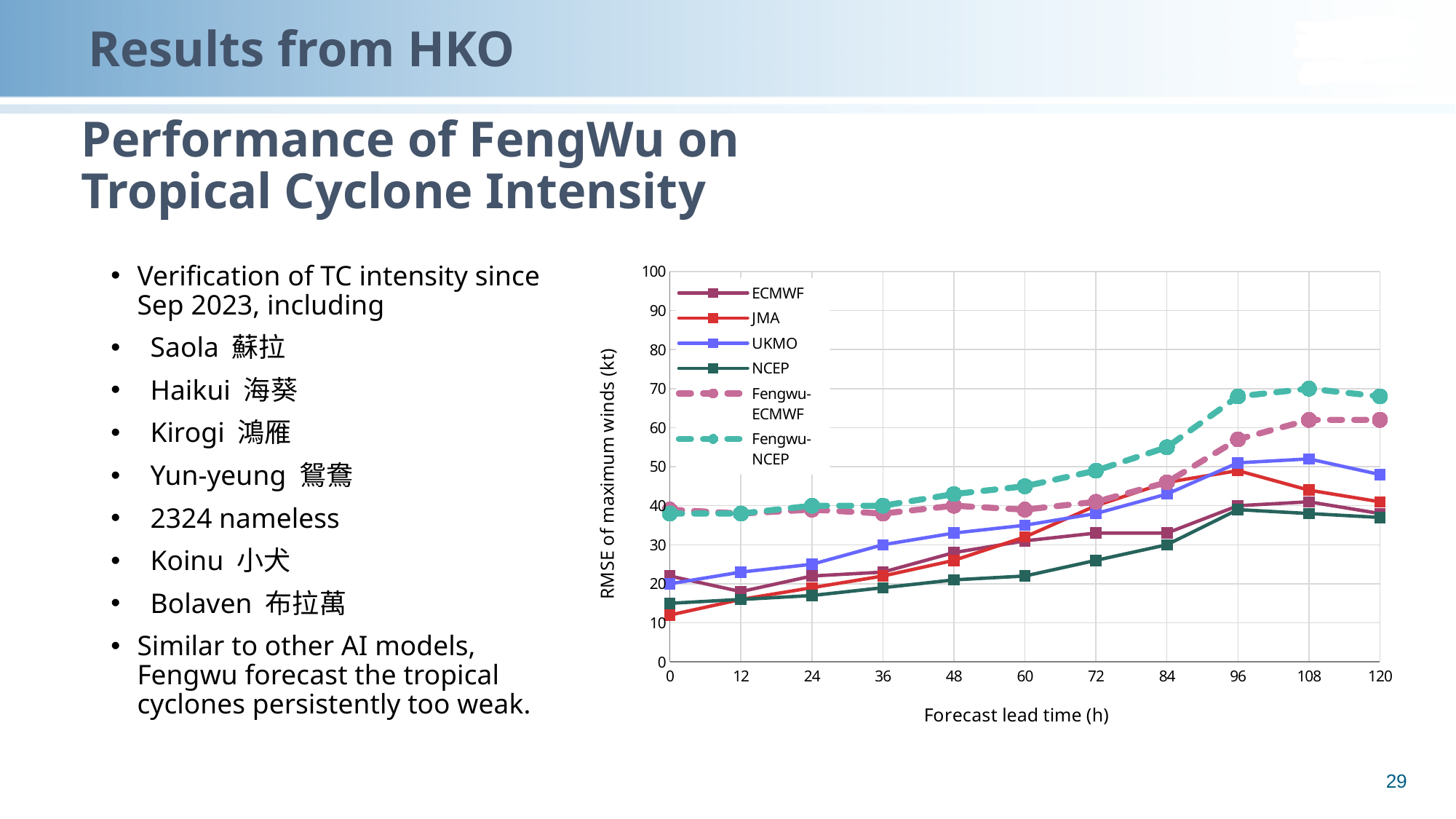
Which series has the highest RMSE at a forecast lead time of 108 h? Fengwu-NCEP Which series has the lowest RMSE at a forecast lead time of 72 h? NCEP What kind of chart is shown on the slide? line chart At a forecast lead time of 0 h, which has the larger RMSE: UKMO or JMA? UKMO Is the Fengwu-NCEP value at a forecast lead time of 120 h greater or less than 60? greater What is the label of the y axis of the chart? RMSE of maximum winds (kt) How many forecast lead times are marked along the x axis of the chart? 11 At a forecast lead time of 120 h, which has the larger RMSE: Fengwu-NCEP or NCEP? Fengwu-NCEP How many series does the chart legend list? 6 Is the NCEP value at a forecast lead time of 0 h greater or less than 20? less Does the Fengwu-NCEP RMSE generally rise or fall as forecast lead time increases? rise Is the UKMO value at a forecast lead time of 96 h greater or less than 40? greater